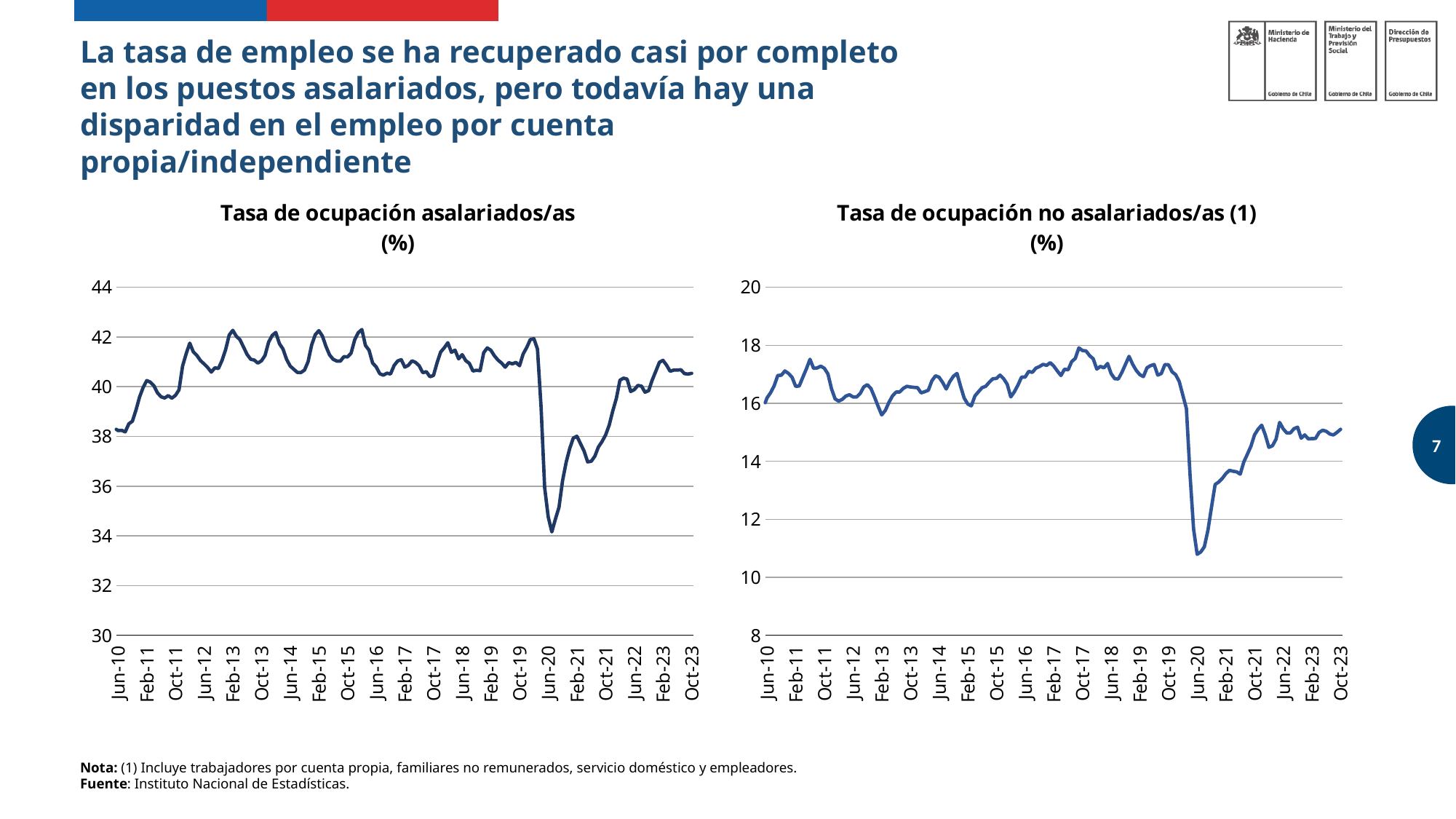
In the left chart 'Tasa de ocupación asalariados/as (%)', is the value for Jun-10 greater or less than 40? less In the left chart 'Tasa de ocupación asalariados/as (%)', is the value for Jun-20 greater or less than 36? less What is the title of the right chart? Tasa de ocupación no asalariados/as (1) (%) In the right chart 'Tasa de ocupación no asalariados/as (1) (%)', is the value for Oct-17 greater or less than 16? greater What is the title of the left chart? Tasa de ocupación asalariados/as (%) In the left chart 'Tasa de ocupación asalariados/as (%)', does the line rise or fall between Jun-20 and Oct-23? rise In the right chart 'Tasa de ocupación no asalariados/as (1) (%)', does the line rise or fall between Oct-19 and Jun-20? fall What kind of chart is the right chart, 'Tasa de ocupación no asalariados/as (1) (%)'? line chart What kind of chart is the left chart, 'Tasa de ocupación asalariados/as (%)'? line chart